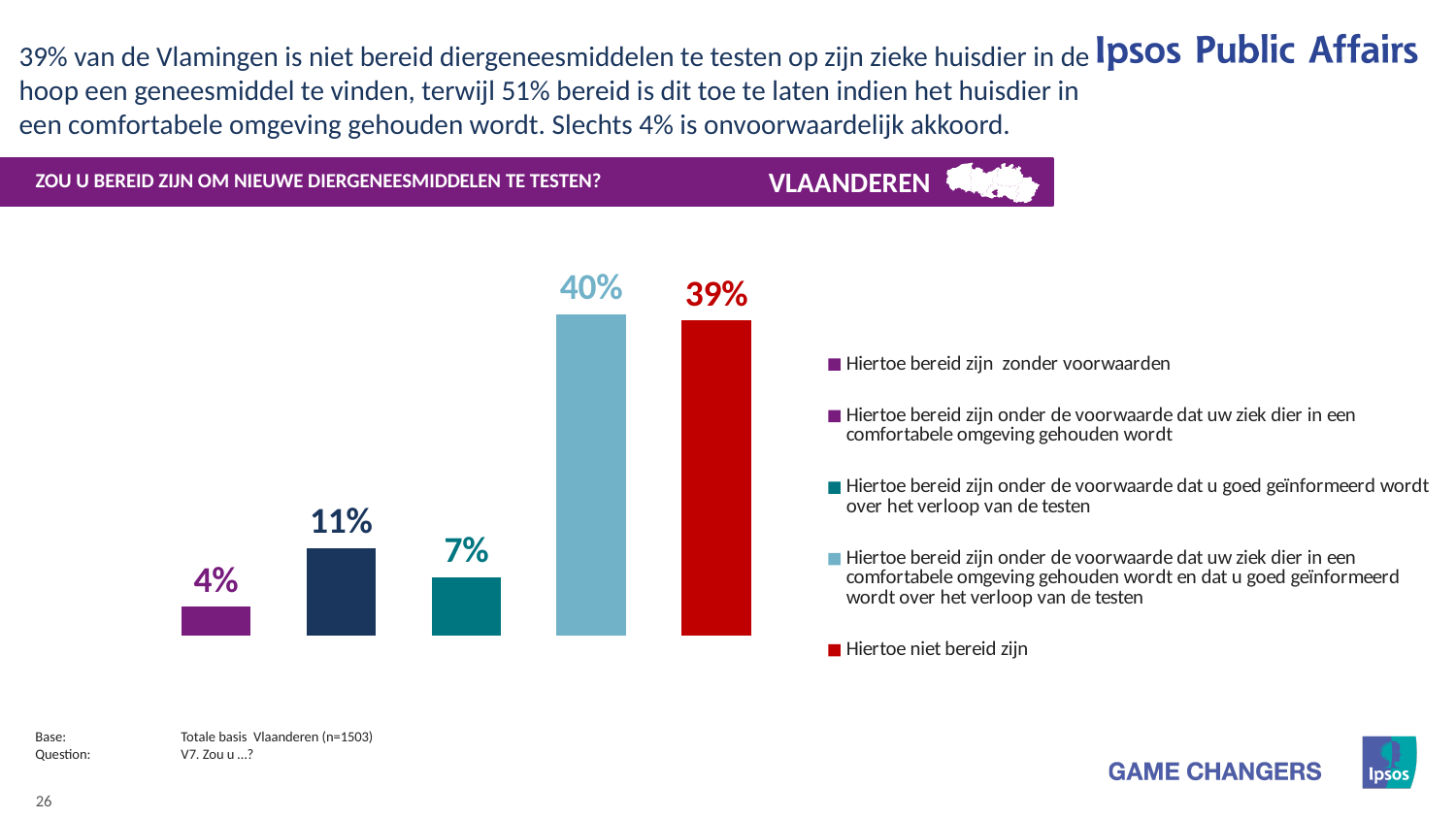
How many bars are plotted in the chart? 5 Which category has the highest value in the chart? Hiertoe bereid zijn onder de voorwaarde dat uw ziek dier in een comfortabele omgeving gehouden wordt en dat u goed geïnformeerd wordt over het verloop van de testen What is the value for 'Hiertoe bereid zijn zonder voorwaarden'? 4% What is the value for 'Hiertoe niet bereid zijn'? 39% Which category has the lowest value in the chart? Hiertoe bereid zijn zonder voorwaarden What is the difference between the value for 'Hiertoe niet bereid zijn' and the value for 'Hiertoe bereid zijn zonder voorwaarden'? 35% Which is larger: the value for the 'comfortabele omgeving' condition alone (11%) or the 'goed geïnformeerd' condition alone? the 'comfortabele omgeving' condition (11%) What colour is the bar for 'Hiertoe niet bereid zijn'? red How many entries does the chart legend list? 5 What is the value for 'Hiertoe bereid zijn onder de voorwaarde dat u goed geïnformeerd wordt over het verloop van de testen'? 7% What is the value for 'Hiertoe bereid zijn onder de voorwaarde dat uw ziek dier in een comfortabele omgeving gehouden wordt'? 11% What kind of chart is shown on the slide? bar chart